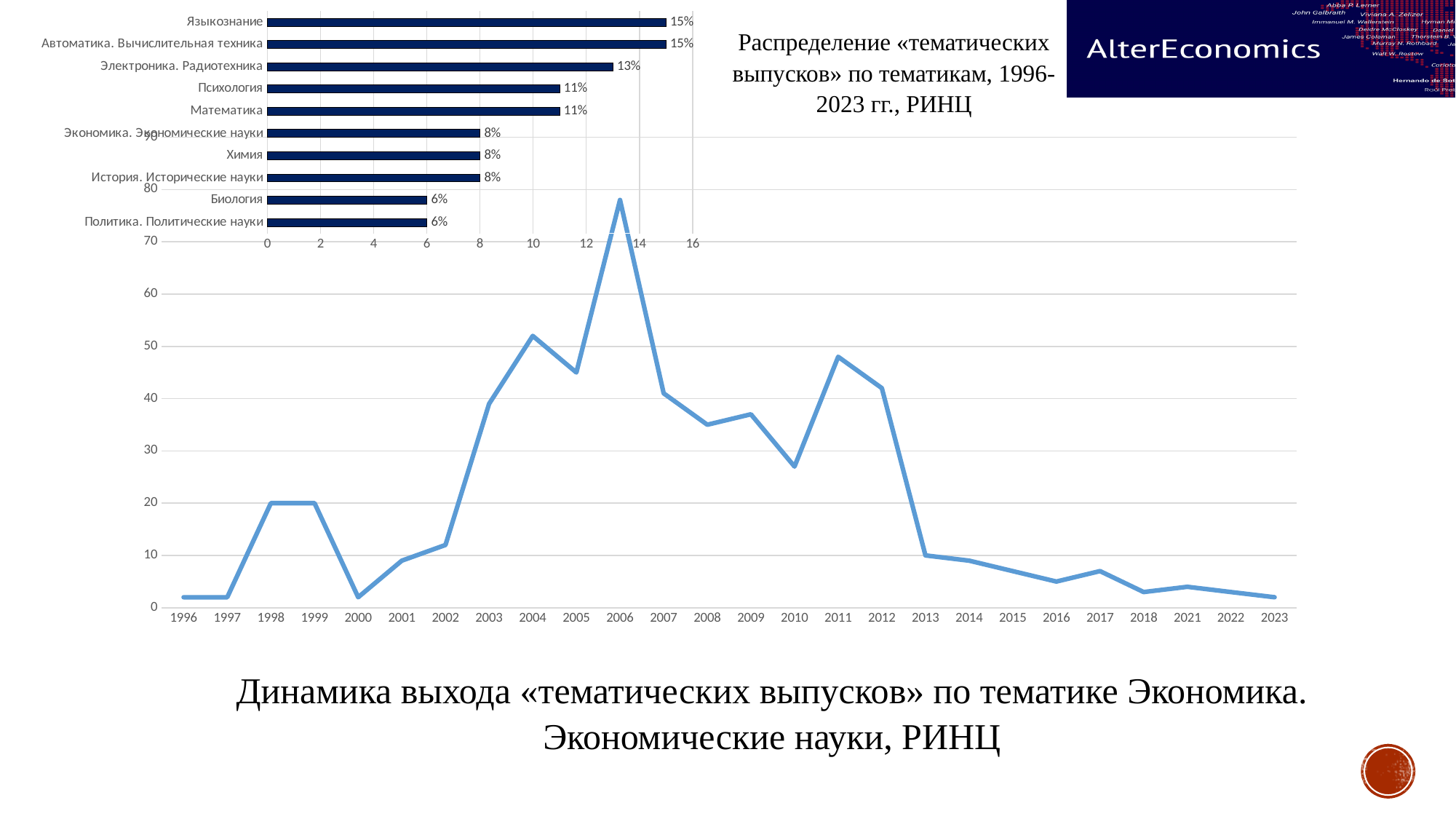
In the line chart titled «Динамика выхода «тематических выпусков» по тематике Экономика. Экономические науки, РИНЦ», do the values rise or fall from 2012 to 2013? fall In the bar chart titled «Распределение «тематических выпусков» по тематикам, 1996-2023 гг., РИНЦ», what is the difference between the values for Языкознание and Политика. Политические науки? 9% In the bar chart titled «Распределение «тематических выпусков» по тематикам, 1996-2023 гг., РИНЦ», what is the value for Экономика. Экономические науки? 8% In the bar chart titled «Распределение «тематических выпусков» по тематикам, 1996-2023 гг., РИНЦ», what is the value for Электроника. Радиотехника? 13% In the bar chart titled «Распределение «тематических выпусков» по тематикам, 1996-2023 гг., РИНЦ», which is larger, the value for Электроника. Радиотехника or the value for Химия? Электроника. Радиотехника How many categories does the bar chart titled «Распределение «тематических выпусков» по тематикам, 1996-2023 гг., РИНЦ» show? 10 In the line chart titled «Динамика выхода «тематических выпусков» по тематике Экономика. Экономические науки, РИНЦ», is the value for 2023 greater or less than 10? less In the line chart titled «Динамика выхода «тематических выпусков» по тематике Экономика. Экономические науки, РИНЦ», which year has the highest value? 2006 In the line chart titled «Динамика выхода «тематических выпусков» по тематике Экономика. Экономические науки, РИНЦ», is the value for 2006 greater or less than 70? greater What kind of chart is the chart titled «Динамика выхода «тематических выпусков» по тематике Экономика. Экономические науки, РИНЦ»? line chart What kind of chart is the chart titled «Распределение «тематических выпусков» по тематикам, 1996-2023 гг., РИНЦ»? bar chart In the bar chart titled «Распределение «тематических выпусков» по тематикам, 1996-2023 гг., РИНЦ», what is the value for Биология? 6%